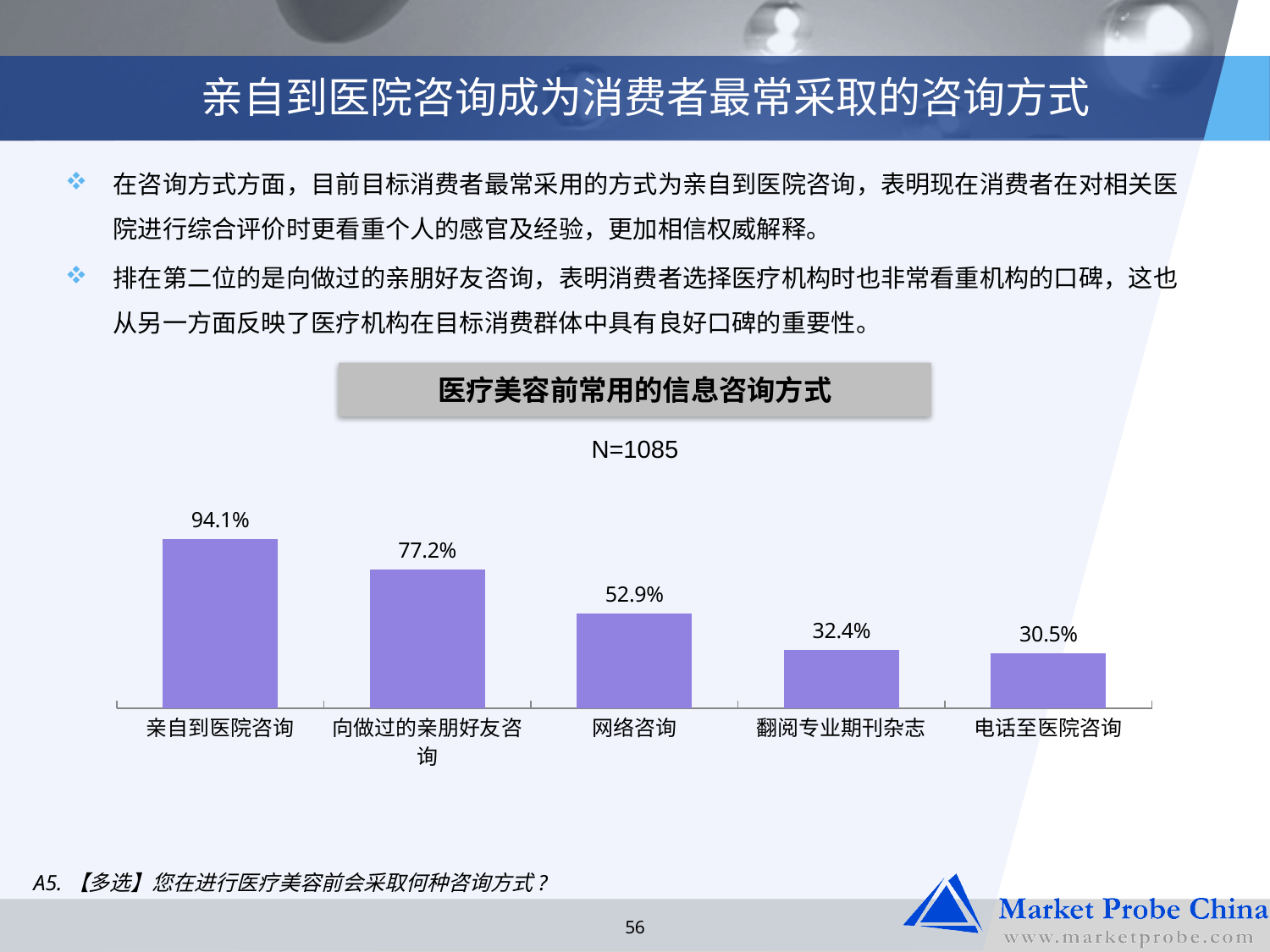
What is the difference between 网络咨询 and 翻阅专业期刊杂志? 20.5% What is the value for 亲自到医院咨询? 94.1% What is the title of the chart? 医疗美容前常用的信息咨询方式 Which is larger, 向做过的亲朋好友咨询 or 网络咨询? 向做过的亲朋好友咨询 Which category has the highest value? 亲自到医院咨询 Do the values rise or fall from left to right along the x axis? fall Which category has the lowest value? 电话至医院咨询 What kind of chart is shown? bar chart What is the value for 电话至医院咨询? 30.5% What is the value for 网络咨询? 52.9% What is the difference between 亲自到医院咨询 and 向做过的亲朋好友咨询? 16.9% How many categories are shown in the chart? 5